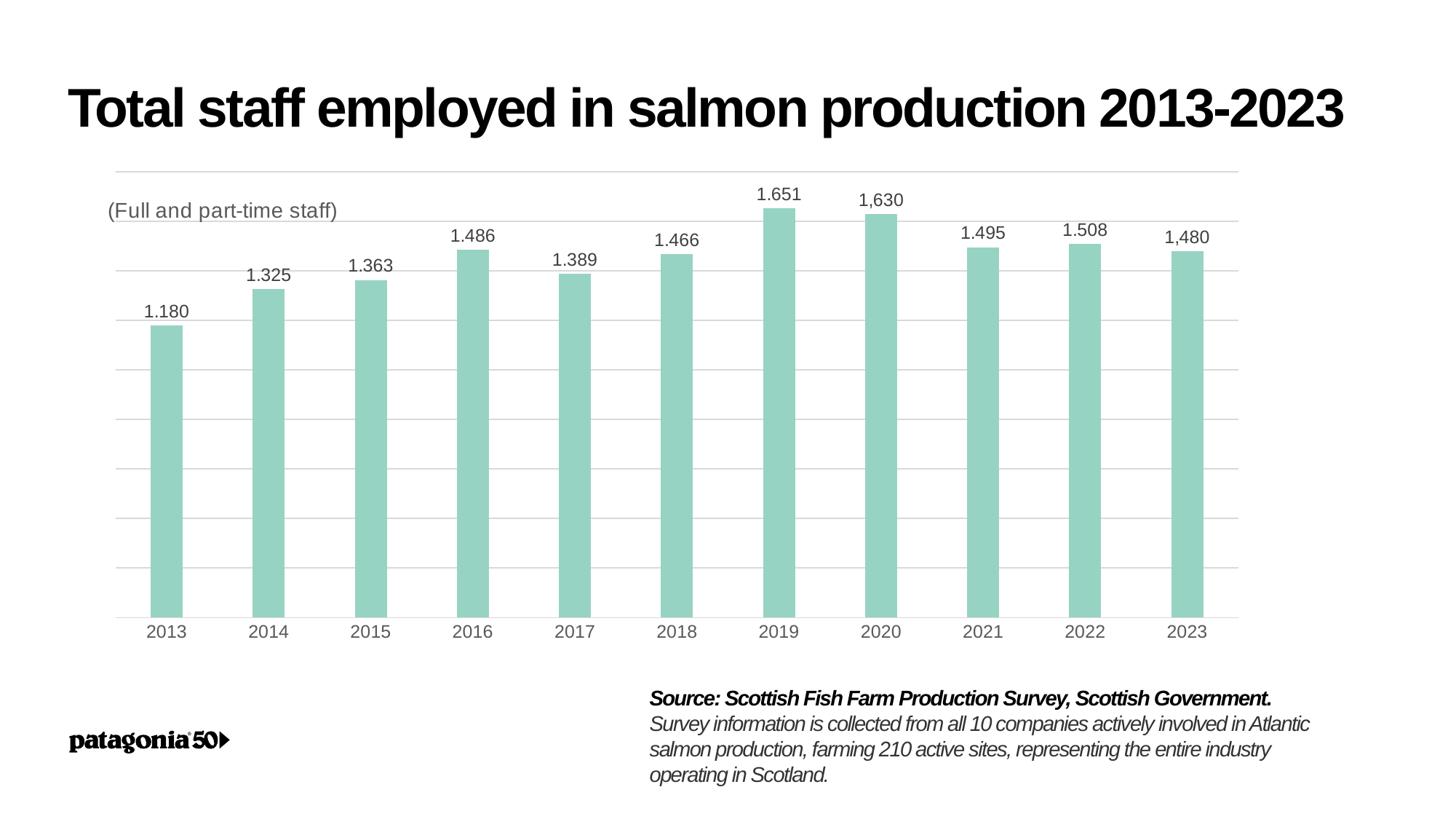
What is the title of the chart? Total staff employed in salmon production 2013-2023 What is the value shown for 2023? 1,480 What is the difference between the value for 2019 and the value for 2013? 471 What is the value shown for 2019? 1.651 What is the value shown for 2017? 1.389 What is the value shown for 2013? 1.180 How many years are shown on the x axis? 11 What type of chart is shown on the slide? bar chart Which year has the highest value? 2019 Which is larger, the value for 2016 or the value for 2017? 2016 Does the value rise or fall from 2013 to 2016? rise Which year has the lowest value? 2013